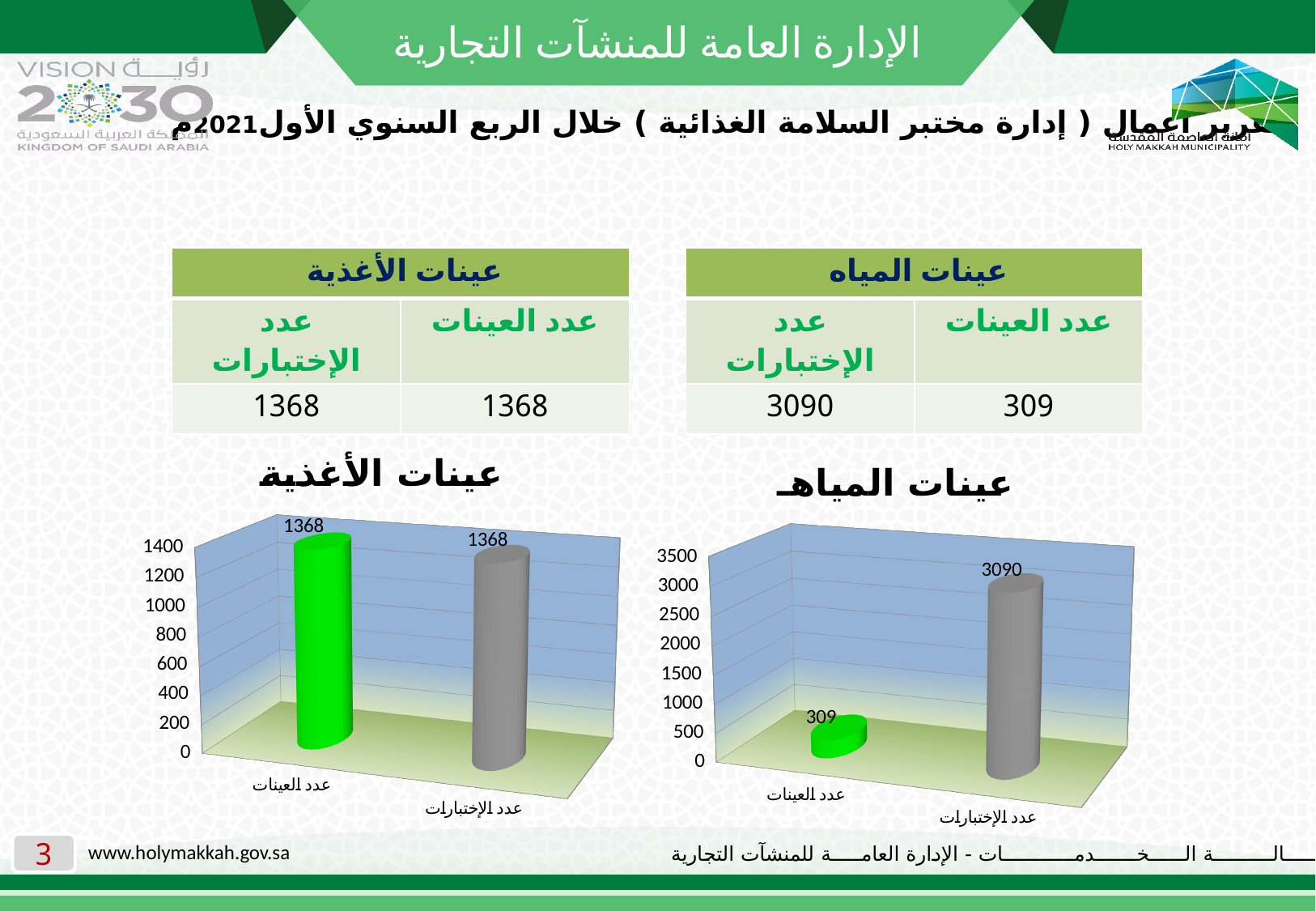
In the chart titled عينات الأغذية, what is the highest value shown on the vertical axis? 1400 In the chart titled عينات المياه, what is the value for عدد الإختبارات? 3090 In the chart titled عينات المياه, which category has the highest value? عدد الإختبارات In the chart titled عينات المياه, which category has the lowest value? عدد العينات In the chart titled عينات الأغذية, what is the value for عدد الإختبارات? 1368 In the chart titled عينات المياه, is the value for عدد الإختبارات greater or less than 2500? greater In the chart titled عينات الأغذية, what is the value for عدد العينات? 1368 What kind of chart is the chart titled عينات المياه? bar chart How many categories are shown in the chart titled عينات الأغذية? 2 In the chart titled عينات المياه, is the value for عدد العينات greater or less than 500? less In the chart titled عينات المياه, what is the difference between عدد الإختبارات and عدد العينات? 2781 In the chart titled عينات المياه, what is the value for عدد العينات? 309